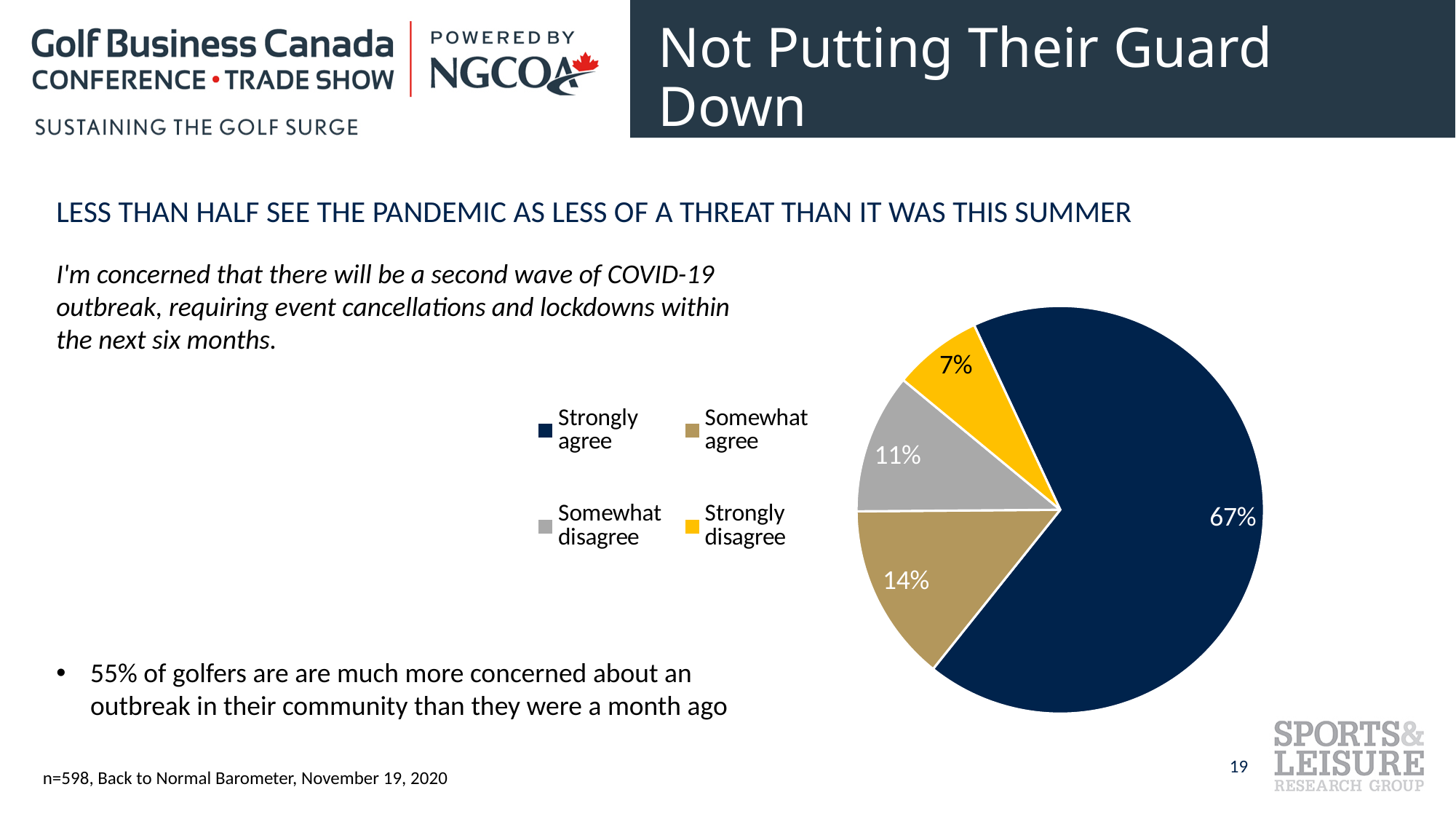
How many slices does the pie chart have? 4 Which response category has the largest slice of the pie? Strongly agree What share of respondents somewhat agree? 14% What share of respondents somewhat disagree? 11% What share of respondents strongly agree that there will be a second wave of COVID-19? 67% What kind of chart is shown on the slide? pie chart What colour is the Strongly disagree slice? yellow Which is larger, the Somewhat disagree slice or the Strongly disagree slice? Somewhat disagree What share of respondents strongly disagree? 7% How many entries does the legend list? 4 Which response category has the smallest slice of the pie? Strongly disagree What is the difference in percentage points between Strongly agree and Somewhat agree? 53